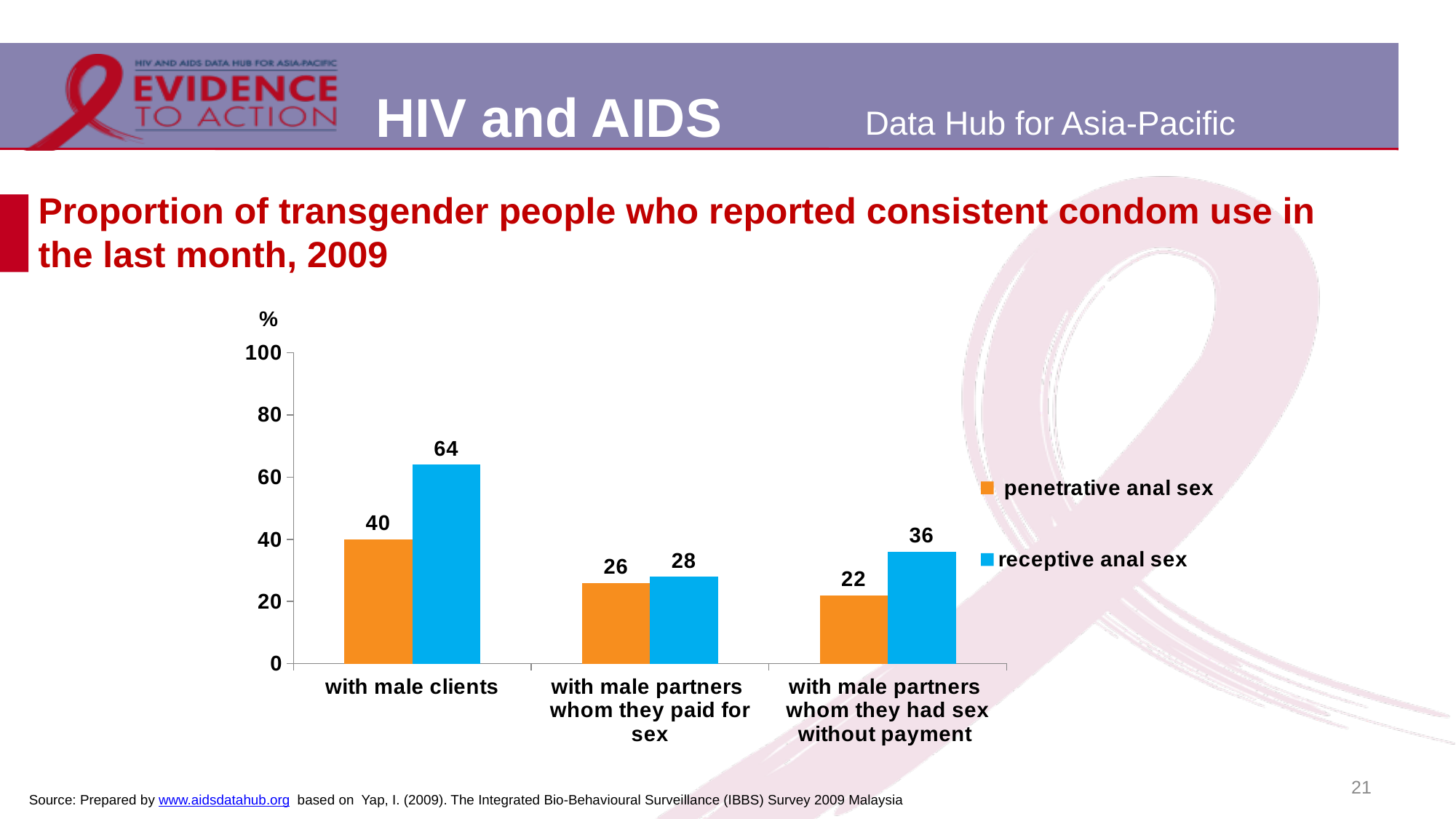
How many categories are shown on the x axis? 3 What is the value for receptive anal sex with male clients? 64 What is the value for penetrative anal sex with male clients? 40 Which colour represents penetrative anal sex in the chart? orange What is the difference between receptive and penetrative anal sex values for the 'with male clients' category? 24 What kind of chart is shown on the slide? bar chart What is the value for penetrative anal sex with male partners whom they paid for sex? 26 Which category has the highest value for receptive anal sex? with male clients Which is larger for the 'with male partners whom they had sex without payment' category: penetrative anal sex or receptive anal sex? receptive anal sex What is the value for receptive anal sex with male partners whom they had sex without payment? 36 How many series does the legend list? 2 Which category has the lowest value for penetrative anal sex? with male partners whom they had sex without payment